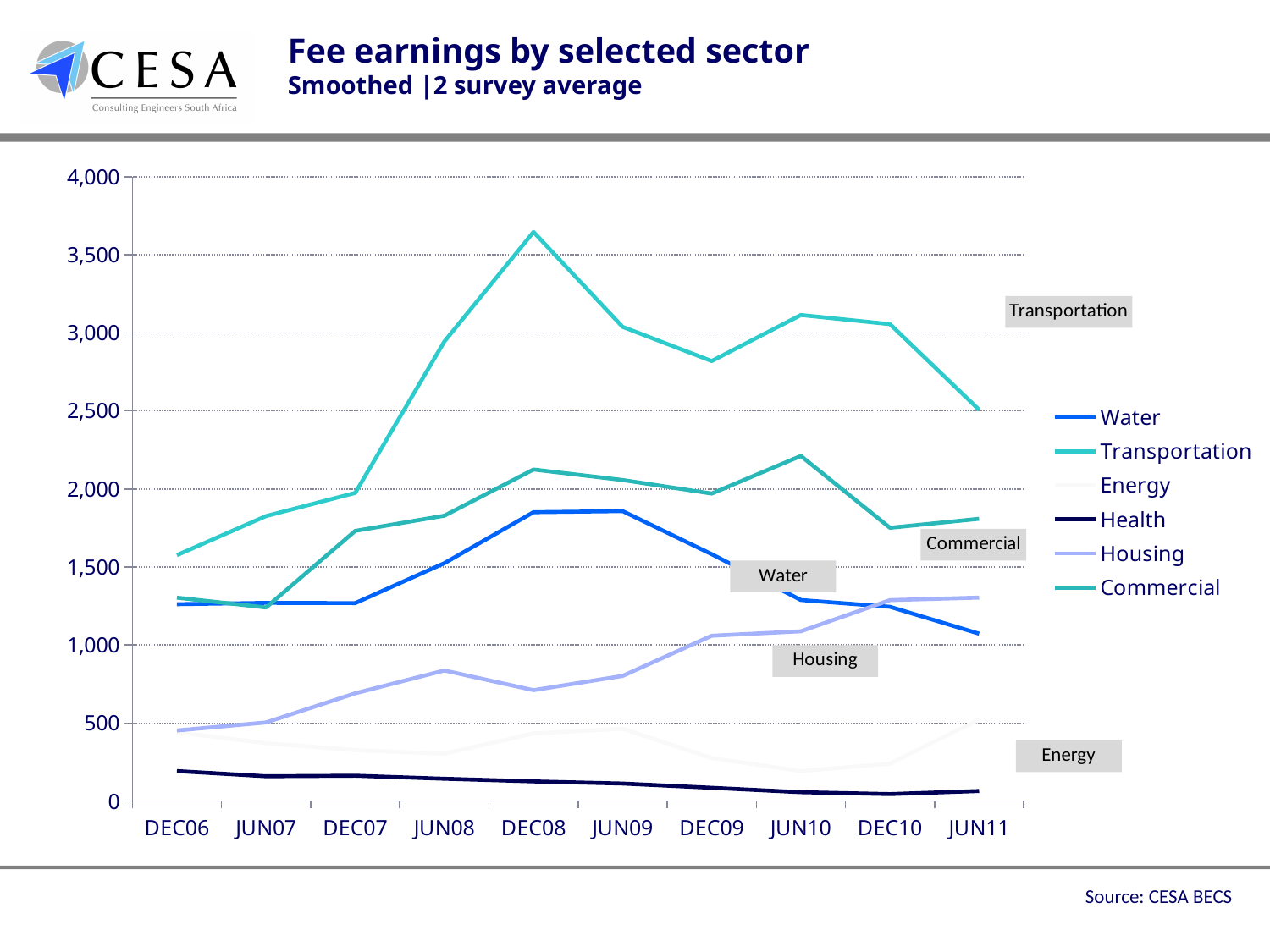
Which sector has the highest fee earnings at DEC08? Transportation Which sector has the lowest fee earnings at JUN11? Health Is the value for Transportation at DEC08 greater or less than 3,500? greater Is the value for Health at DEC06 greater or less than 500? less How many survey periods are shown along the x axis? 10 Is the value for Housing at JUN11 greater or less than 1,000? greater What kind of chart is shown on the slide? line chart Do the Health values rise or fall from DEC06 to JUN11? fall How many series does the legend list? 6 What is the title of the chart on the slide? Fee earnings by selected sector At JUN09, which is larger: Transportation or Water? Transportation